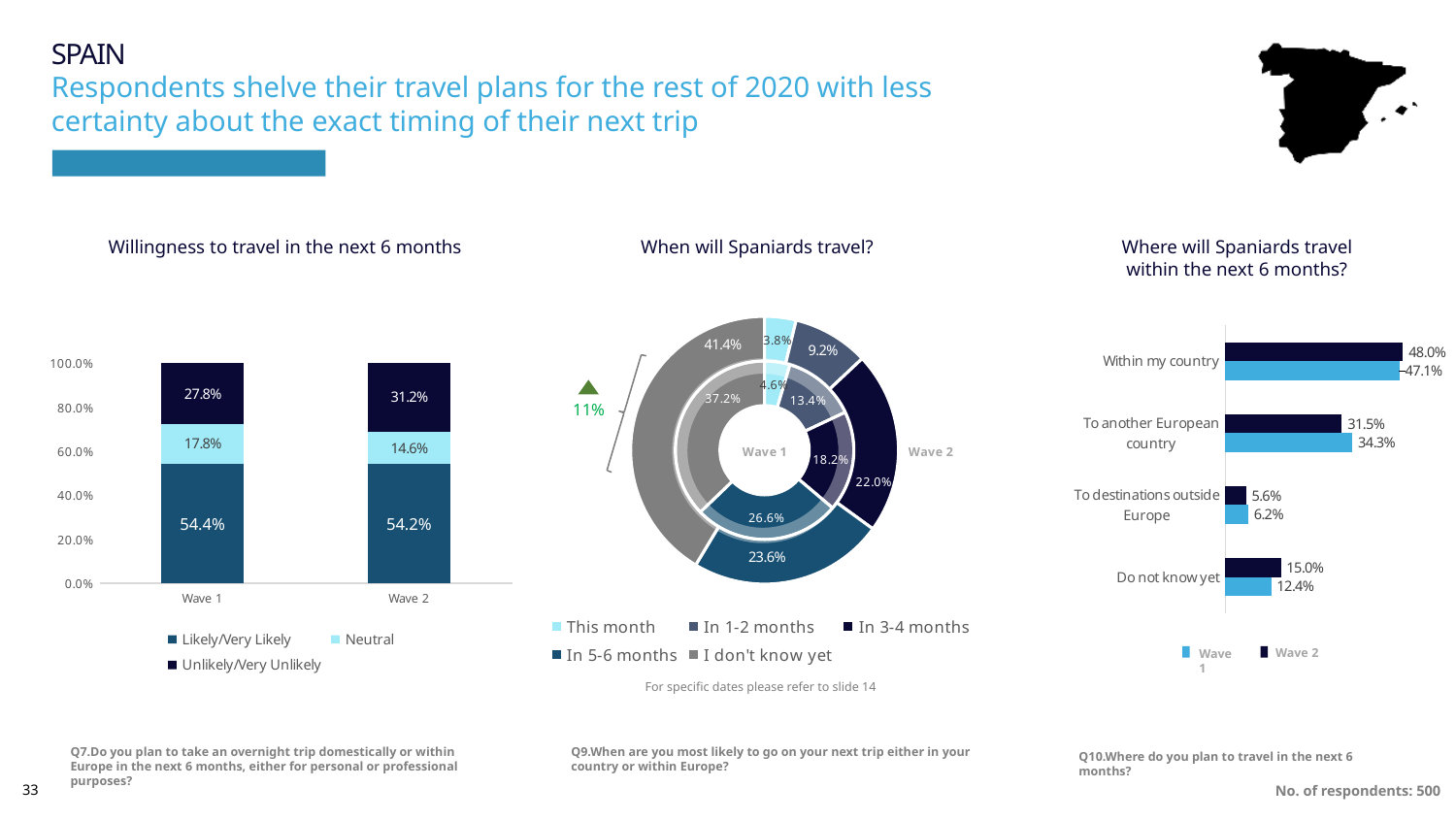
In the 'When will Spaniards travel?' chart, which category has the smallest share in Wave 2? This month In the 'When will Spaniards travel?' chart, what is the Wave 2 value for 'I don't know yet'? 41.4% In the 'Where will Spaniards travel within the next 6 months?' chart, what is the Wave 1 value for 'To another European country'? 34.3% In the 'Willingness to travel in the next 6 months' chart, how many series does the legend list? 3 What kind of chart is 'Willingness to travel in the next 6 months'? Stacked bar chart In the 'Where will Spaniards travel within the next 6 months?' chart, is the Wave 2 value for 'Do not know yet' larger or smaller than the Wave 1 value? Larger In the 'Willingness to travel in the next 6 months' chart, what is the Neutral value for Wave 2? 14.6% In the 'Where will Spaniards travel within the next 6 months?' chart, which destination has the highest value in Wave 2? Within my country In the 'When will Spaniards travel?' chart, how many categories does the legend list? 5 In the 'When will Spaniards travel?' chart, what is the Wave 1 value for 'In 5-6 months'? 26.6% In the 'Willingness to travel in the next 6 months' chart, what is the Likely/Very Likely value for Wave 1? 54.4% In the 'Willingness to travel in the next 6 months' chart, what is the difference between the Unlikely/Very Unlikely values for Wave 2 and Wave 1? 3.4%